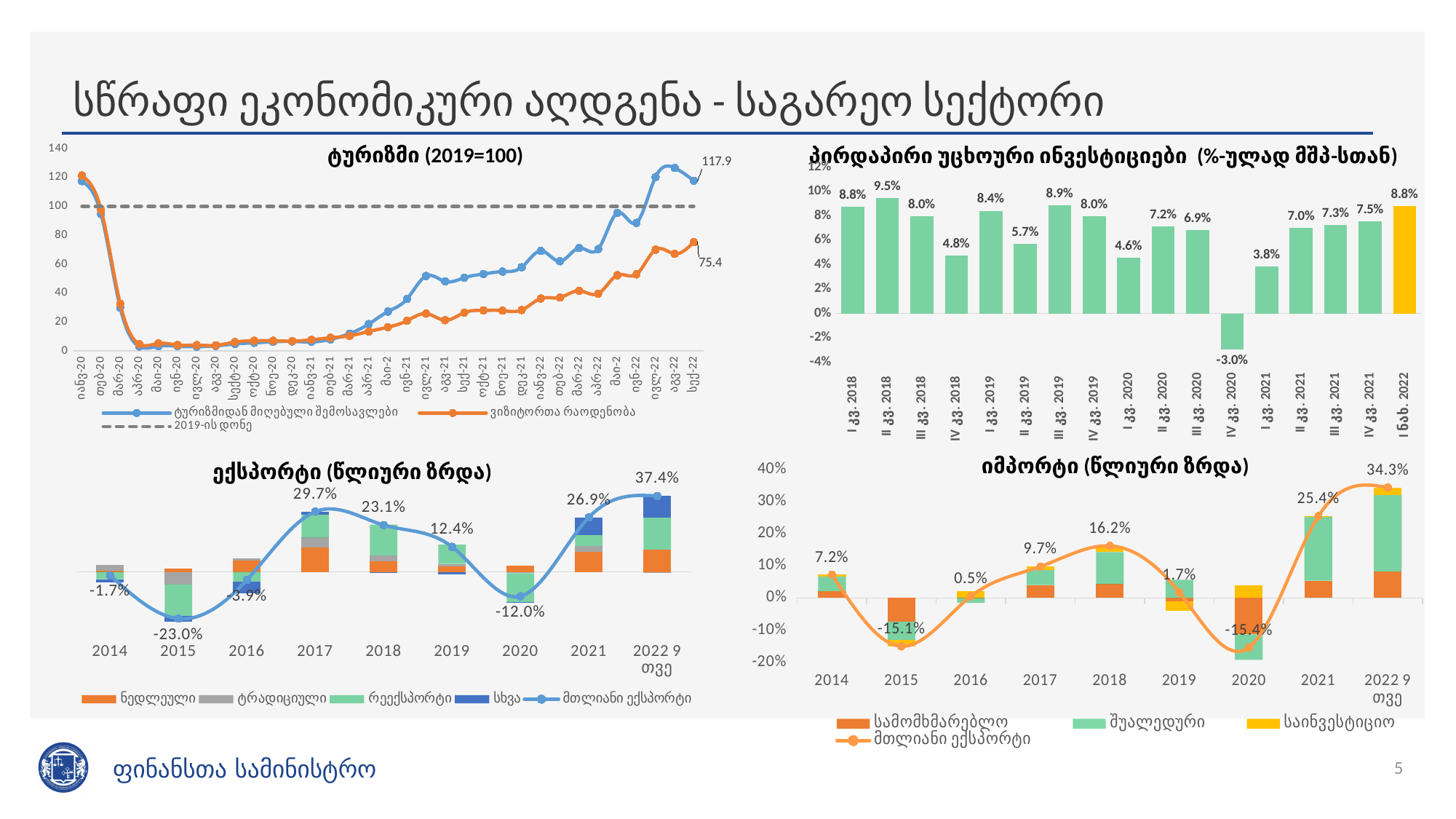
In the 'ექსპორტი (წლიური ზრდა)' chart, which year has the lowest total export growth? 2015 In the 'იმპორტი (წლიური ზრდა)' chart, what is the value for 2018? 16.2% In the 'პირდაპირი უცხოური ინვესტიციები' chart, which quarter has the highest value? II კვ. 2018 In the 'პირდაპირი უცხოური ინვესტიციები' chart, what is the difference between III კვ. 2019 and IV კვ. 2019? 0.9% In the 'პირდაპირი უცხოური ინვესტიციები' chart, how many bars are plotted? 17 In the 'იმპორტი (წლიური ზრდა)' chart, which is larger, the value for 2015 or the value for 2020? 2015 In the 'იმპორტი (წლიური ზრდა)' chart, what is the difference between the 2022 9 თვე value and the 2021 value? 8.9% In the 'ტურიზმი (2019=100)' chart, what is the final labelled value of the orange line (ვიზიტორთა რაოდენობა)? 75.4 In the 'ექსპორტი (წლიური ზრდა)' chart, how many entries does the legend list? 5 In the 'ექსპორტი (წლიური ზრდა)' chart, what is the total export growth value for 2017? 29.7% In the 'პირდაპირი უცხოური ინვესტიციები' chart, what is the value for IV კვ. 2020? -3.0% In the 'ტურიზმი (2019=100)' chart, what is the final labelled value of the blue line (ტურიზმიდან მიღებული შემოსავლები)? 117.9